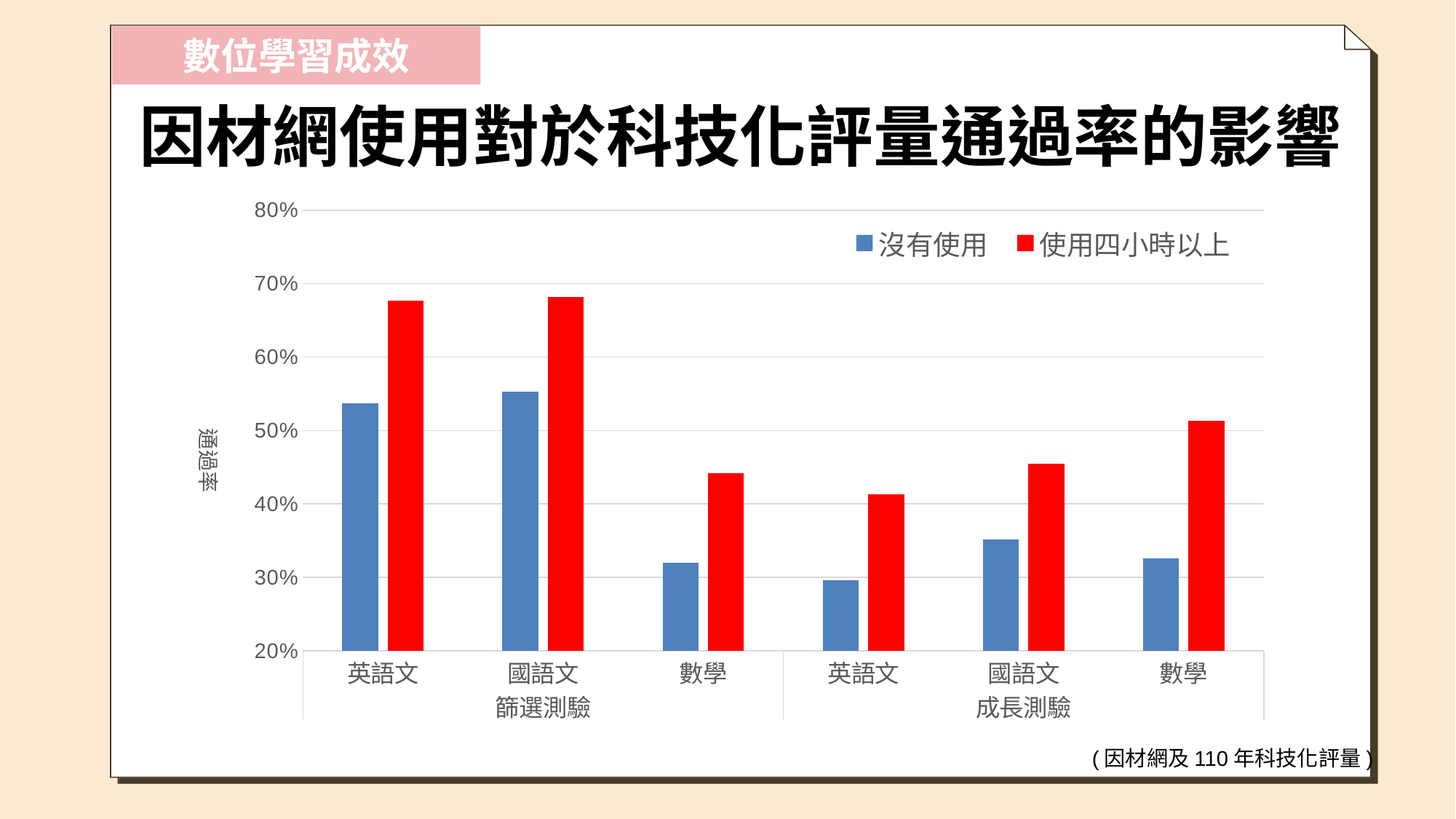
For 國語文 in 篩選測驗, which series has the larger value, 沒有使用 or 使用四小時以上? 使用四小時以上 Within the 使用四小時以上 series, which subject in 成長測驗 has the lowest pass rate? 英語文 Within the 沒有使用 series, which subject in 成長測驗 has the highest pass rate? 國語文 What are the two series named in the legend? 沒有使用, 使用四小時以上 Is the 沒有使用 value for 數學 in 篩選測驗 greater or less than 40%? less What kind of chart is shown on the slide? bar chart What is the label on the vertical axis of the chart? 通過率 Is the 使用四小時以上 value for 數學 in 成長測驗 greater or less than 50%? greater Is the 使用四小時以上 value for 英語文 in 篩選測驗 greater or less than 60%? greater How many category groups (subject bars pairs) are plotted along the x axis? 6 How many series does the legend list? 2